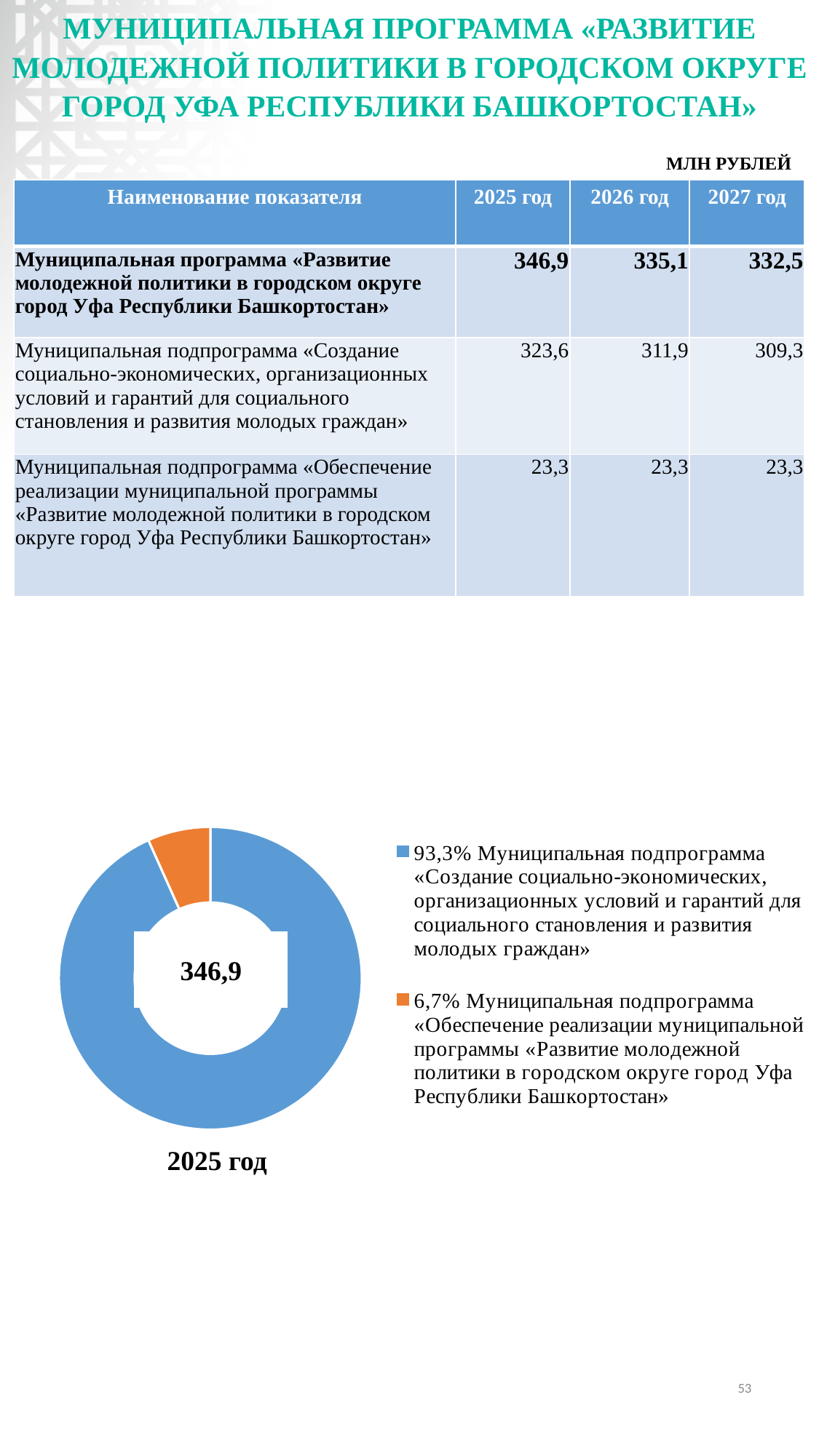
How many entries does the legend of the doughnut chart list? 2 What is the difference in percentage points between the two slices of the doughnut chart? 86,6 How many slices does the doughnut chart have? 2 Which year does the doughnut chart represent, according to the label beneath it? 2025 год What value is printed in the centre of the doughnut chart? 346,9 What share of the doughnut chart does the subprogram «Обеспечение реализации муниципальной программы «Развитие молодежной политики в городском округе город Уфа Республики Башкортостан» take? 6,7% Which slice of the doughnut chart is the largest? Муниципальная подпрограмма «Создание социально-экономических, организационных условий и гарантий для социального становления и развития молодых граждан» Is the share of the orange slice in the doughnut chart greater or less than 10%? less Which slice of the doughnut chart is the smallest? Муниципальная подпрограмма «Обеспечение реализации муниципальной программы «Развитие молодежной политики в городском округе город Уфа Республики Башкортостан» What kind of chart is shown at the bottom of the slide? Doughnut (pie) chart What share of the doughnut chart does the subprogram «Создание социально-экономических, организационных условий и гарантий для социального становления и развития молодых граждан» take? 93,3% In the doughnut chart, which is larger: the share of the subprogram «Создание социально-экономических...» or the share of the subprogram «Обеспечение реализации...»? Муниципальная подпрограмма «Создание социально-экономических, организационных условий и гарантий для социального становления и развития молодых граждан»